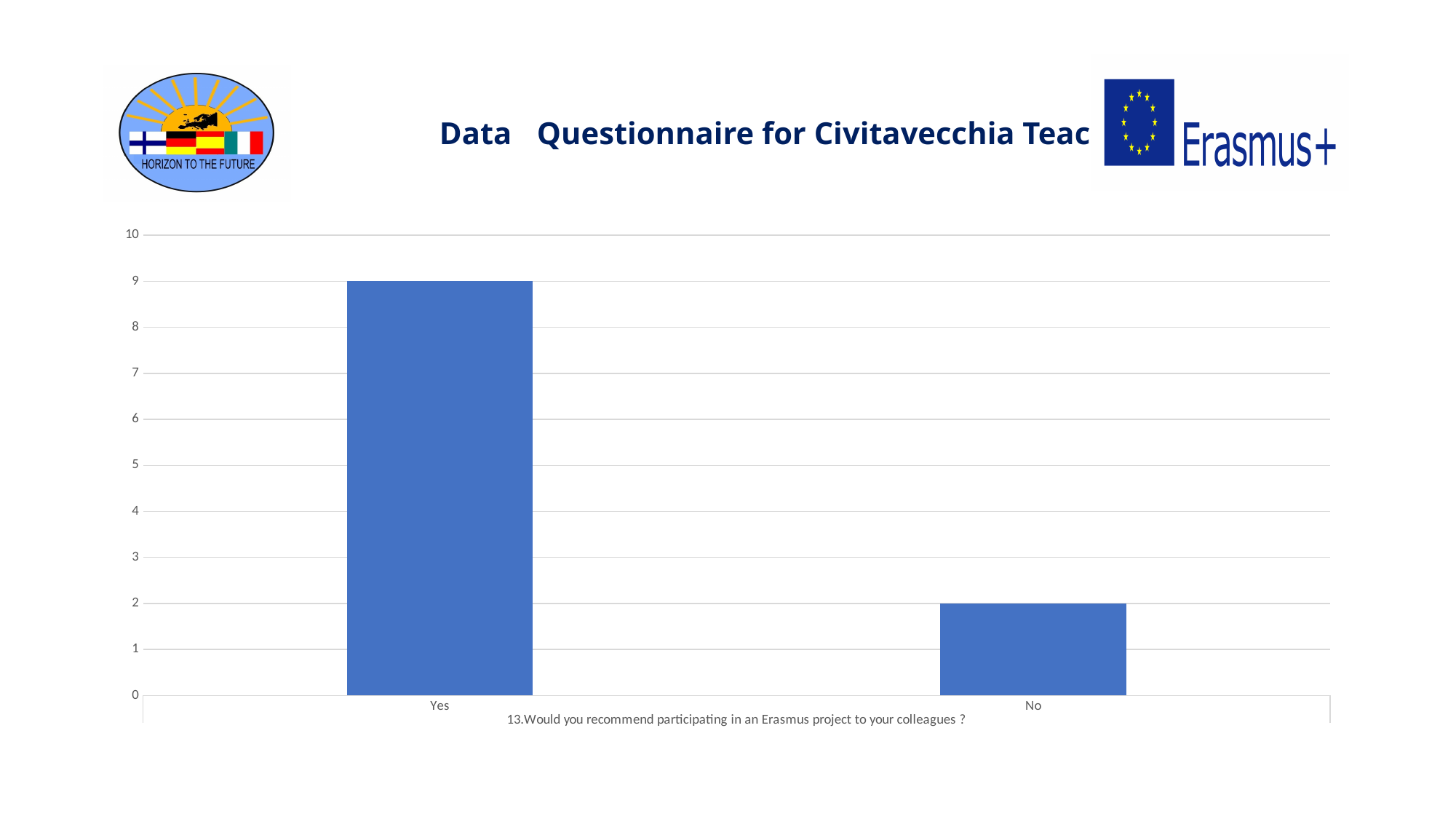
Is the value for "No" greater or less than 5? less How many categories are shown on the x axis of the chart? 2 What question is written as the x-axis label of the chart? 13.Would you recommend participating in an Erasmus project to your colleagues ? What is the difference between the values for "Yes" and "No"? 7 What is the value for "Yes" in the chart? 9 What is the value for "No" in the chart? 2 What kind of chart is shown on the slide? bar chart What is the highest value shown on the vertical axis of the chart? 10 Is the value for "Yes" greater or less than 5? greater Which category has the lowest value in the chart? No Which is larger, the value for "Yes" or the value for "No"? Yes Which category has the highest value in the chart? Yes